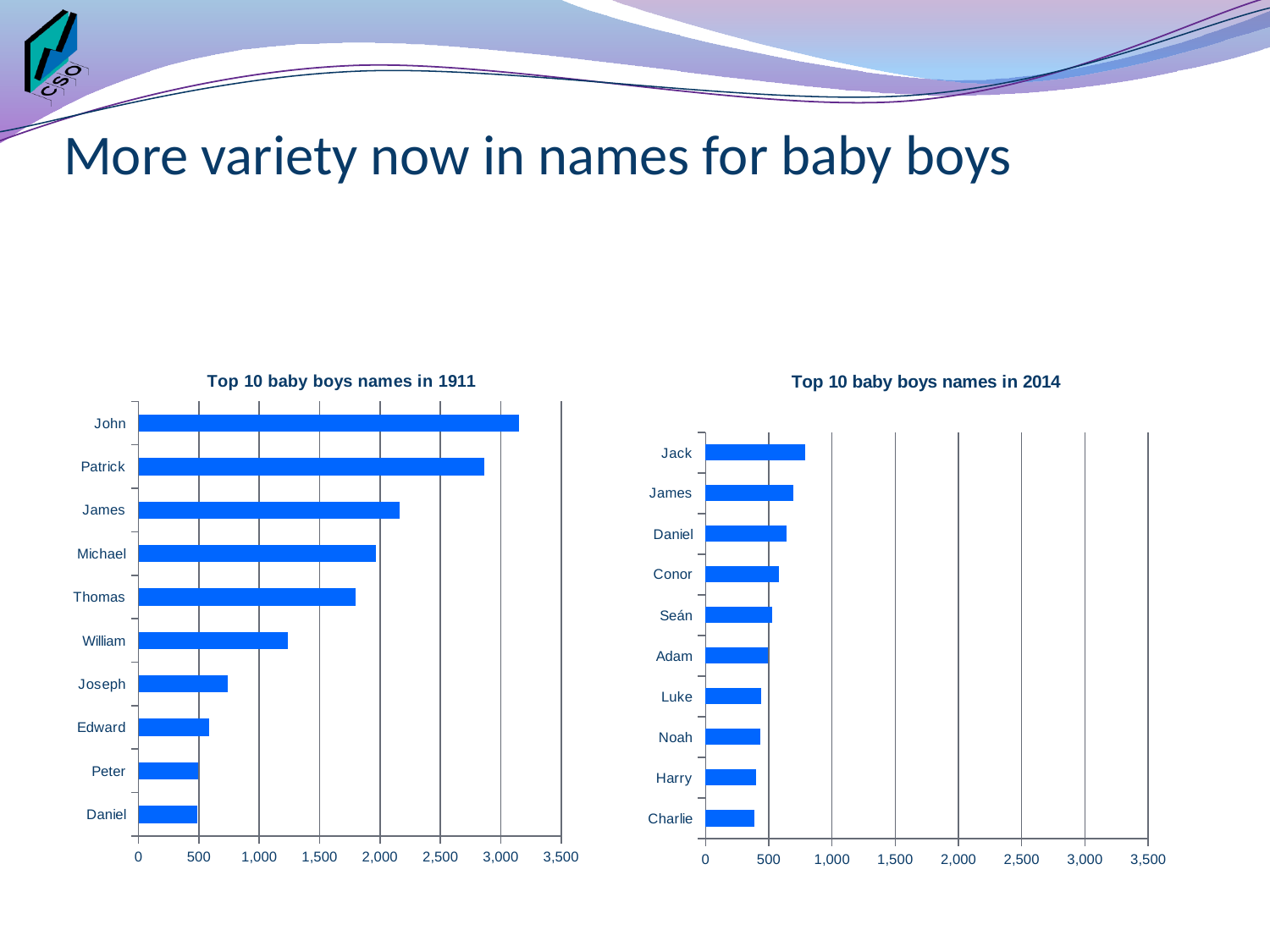
In the 'Top 10 baby boys names in 2014' chart, is the value for Charlie greater or less than 500? less In the 'Top 10 baby boys names in 1911' chart, is the value for William greater or less than 1,500? less In the 'Top 10 baby boys names in 1911' chart, is the value for John greater or less than 3,000? greater In the 'Top 10 baby boys names in 2014' chart, which name has the highest value? Jack In the 'Top 10 baby boys names in 1911' chart, which is larger, the value for Patrick or the value for James? Patrick How many names are shown in the 'Top 10 baby boys names in 2014' chart? 10 What kind of chart is the 'Top 10 baby boys names in 1911' chart? bar chart In the 'Top 10 baby boys names in 2014' chart, which is larger, the value for Daniel or the value for Luke? Daniel In the 'Top 10 baby boys names in 1911' chart, which name has the highest value? John What is the title of the chart on the left of the slide? Top 10 baby boys names in 1911